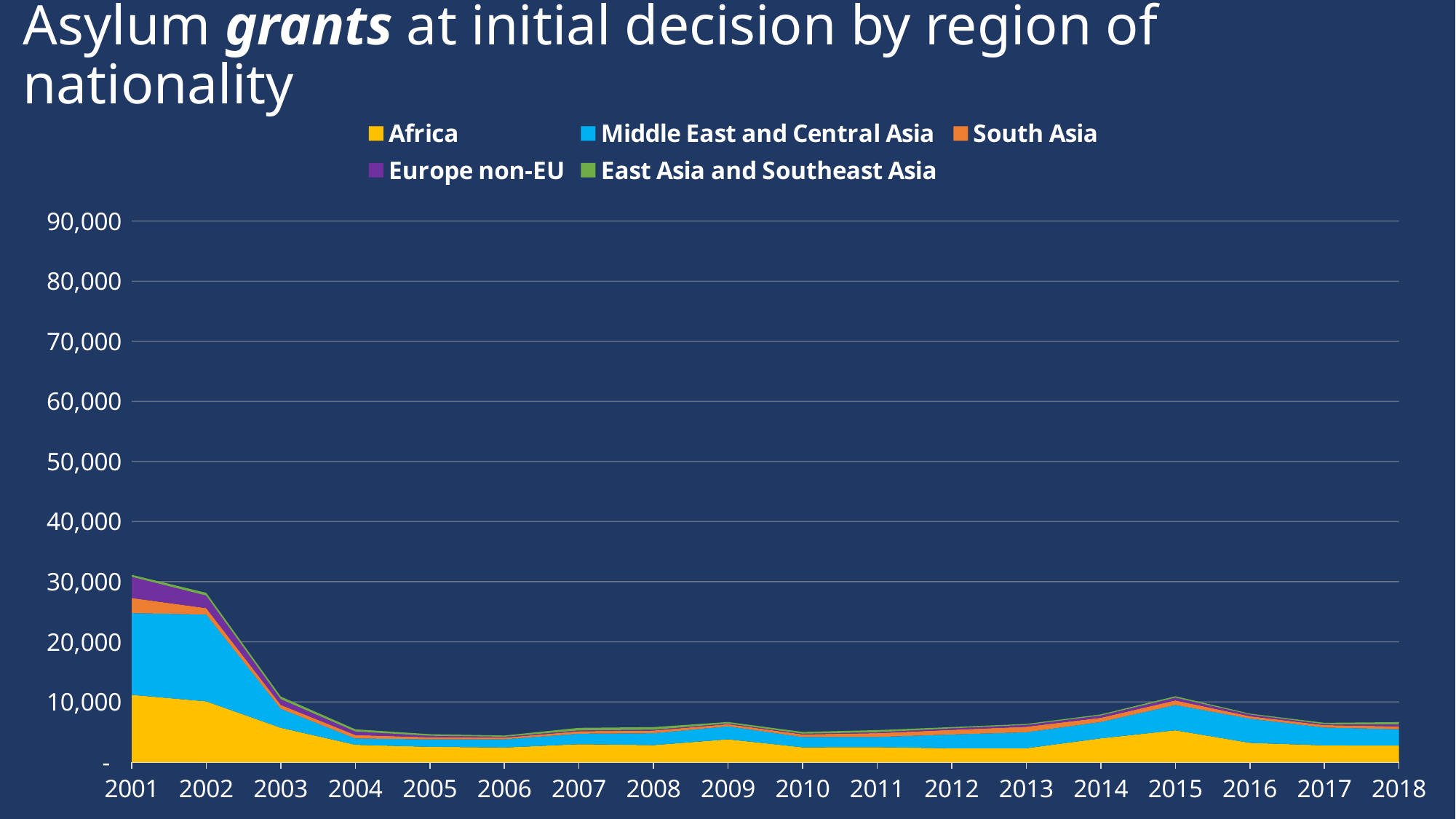
Do total asylum grants rise or fall between 2001 and 2004? fall In which year is the total number of asylum grants highest? 2001 How many series does the legend list? 5 What kind of chart is shown on the slide? Stacked area chart Which colour represents Africa in the chart? Yellow Is the total number of asylum grants in 2015 greater or less than 20,000? less Which year has the larger total of asylum grants, 2010 or 2015? 2015 Which year has the larger total of asylum grants, 2001 or 2015? 2001 How many years are shown along the x axis? 18 Is the total number of asylum grants in 2015 greater or less than 5,000? greater Is the value for Africa in 2001 greater or less than 5,000? greater